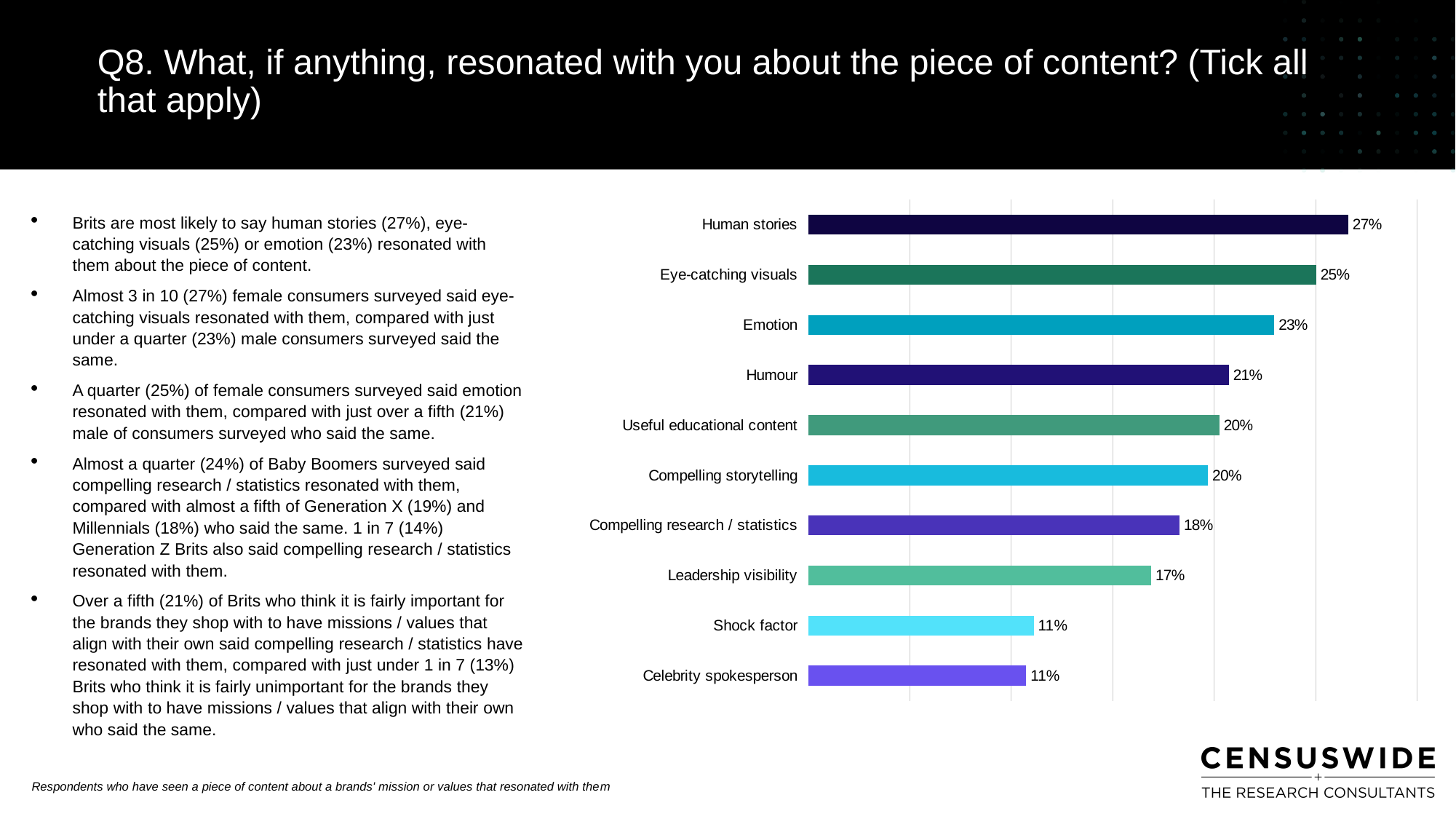
What is the difference between the values for Eye-catching visuals and Shock factor? 14% What is the value shown for Compelling research / statistics? 18% How many categories are shown in the chart? 10 What is the difference between the values for Human stories and Emotion? 4% Which has a higher value, Emotion or Compelling storytelling? Emotion Which has a higher value, Humour or Leadership visibility? Humour What is the value shown for Leadership visibility? 17% Which categories share the lowest value in the chart? Shock factor and Celebrity spokesperson What percentage of respondents said human stories resonated with them? 27% What type of chart is shown on the slide? Bar chart Which two categories both have a value of 20%? Useful educational content and Compelling storytelling Which category has the highest value in the chart? Human stories